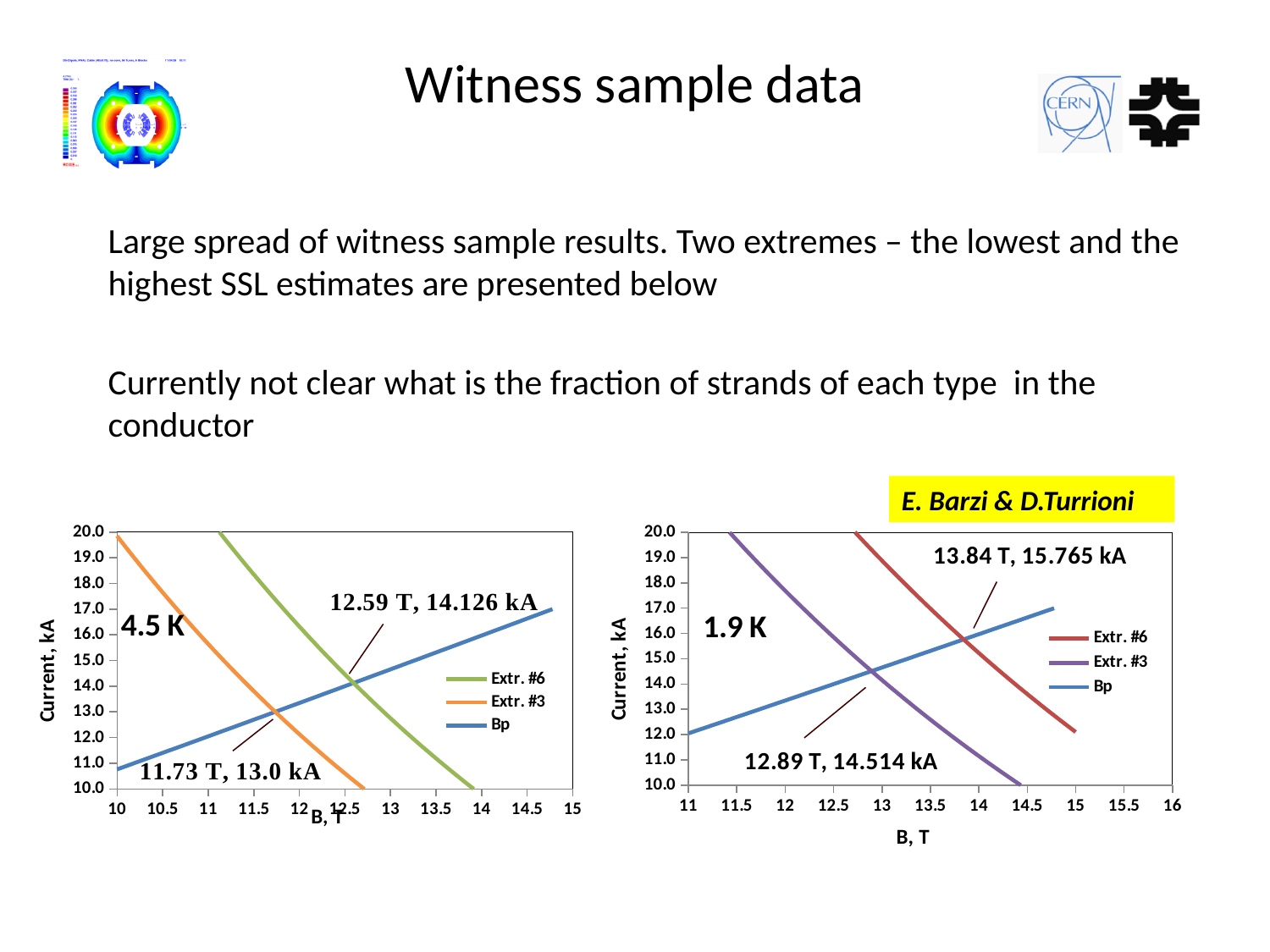
In the right chart labelled 1.9 K, does the Bp line rise or fall as B increases? rise What kind of chart is the left chart labelled 4.5 K? line chart In the left chart labelled 4.5 K, does the Extr. #3 curve rise or fall as B increases? fall In the left chart labelled 4.5 K, at what field and current does the Extr. #6 curve cross the Bp line, according to the annotation? 12.59 T, 14.126 kA In the left chart labelled 4.5 K, what are the legend entries? Extr. #6, Extr. #3, Bp In the right chart labelled 1.9 K, at what field and current does the Extr. #3 curve cross the Bp line, according to the annotation? 12.89 T, 14.514 kA In the left chart labelled 4.5 K, what is the difference in current between the two annotated crossing points? 1.126 kA In the right chart labelled 1.9 K, what is the difference in current between the two annotated crossing points? 1.251 kA In the right chart labelled 1.9 K, at what field and current does the Extr. #6 curve cross the Bp line, according to the annotation? 13.84 T, 15.765 kA How many series does the legend of the right chart labelled 1.9 K list? 3 In the left chart labelled 4.5 K, at what field and current does the Extr. #3 curve cross the Bp line, according to the annotation? 11.73 T, 13.0 kA Which annotated crossing current is larger: the Extr. #6 crossing in the 4.5 K chart or the Extr. #6 crossing in the 1.9 K chart? the 1.9 K chart